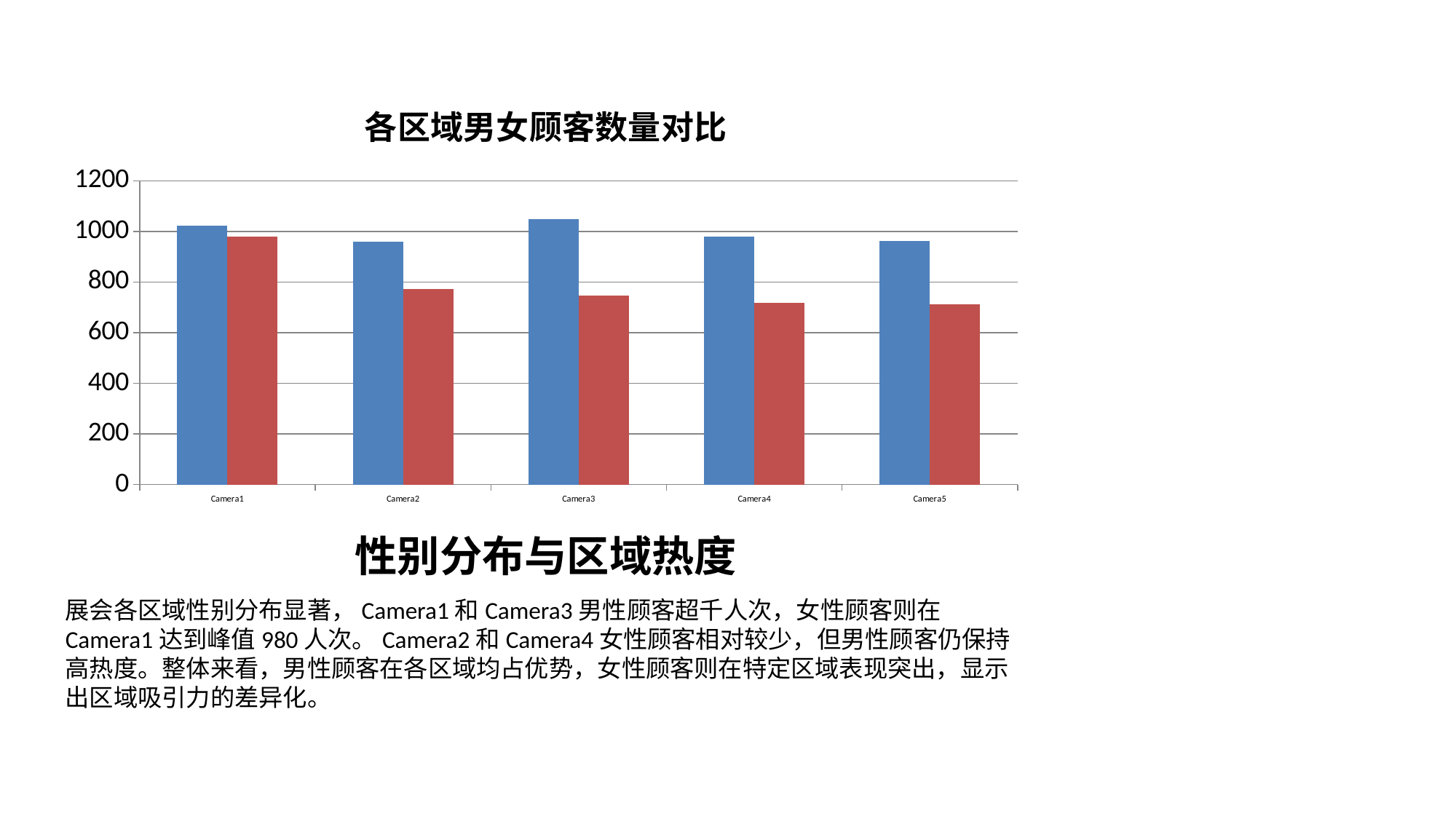
What kind of chart is shown on the slide? bar chart What is the title of the chart? 各区域男女顾客数量对比 Do the red bars rise or fall from Camera1 to Camera5? fall Is the value of the blue bar for Camera3 greater or less than 1000? greater Is the value of the blue bar for Camera2 greater or less than 1000? less Is the value of the red bar for Camera4 greater or less than 800? less How many categories are shown on the x axis of the chart? 5 Which is larger: the red bar for Camera1 or the red bar for Camera5? the red bar for Camera1 For Camera3, which bar is taller, the blue one or the red one? the blue one Which category has the tallest red bar? Camera1 Which category has the tallest blue bar? Camera3